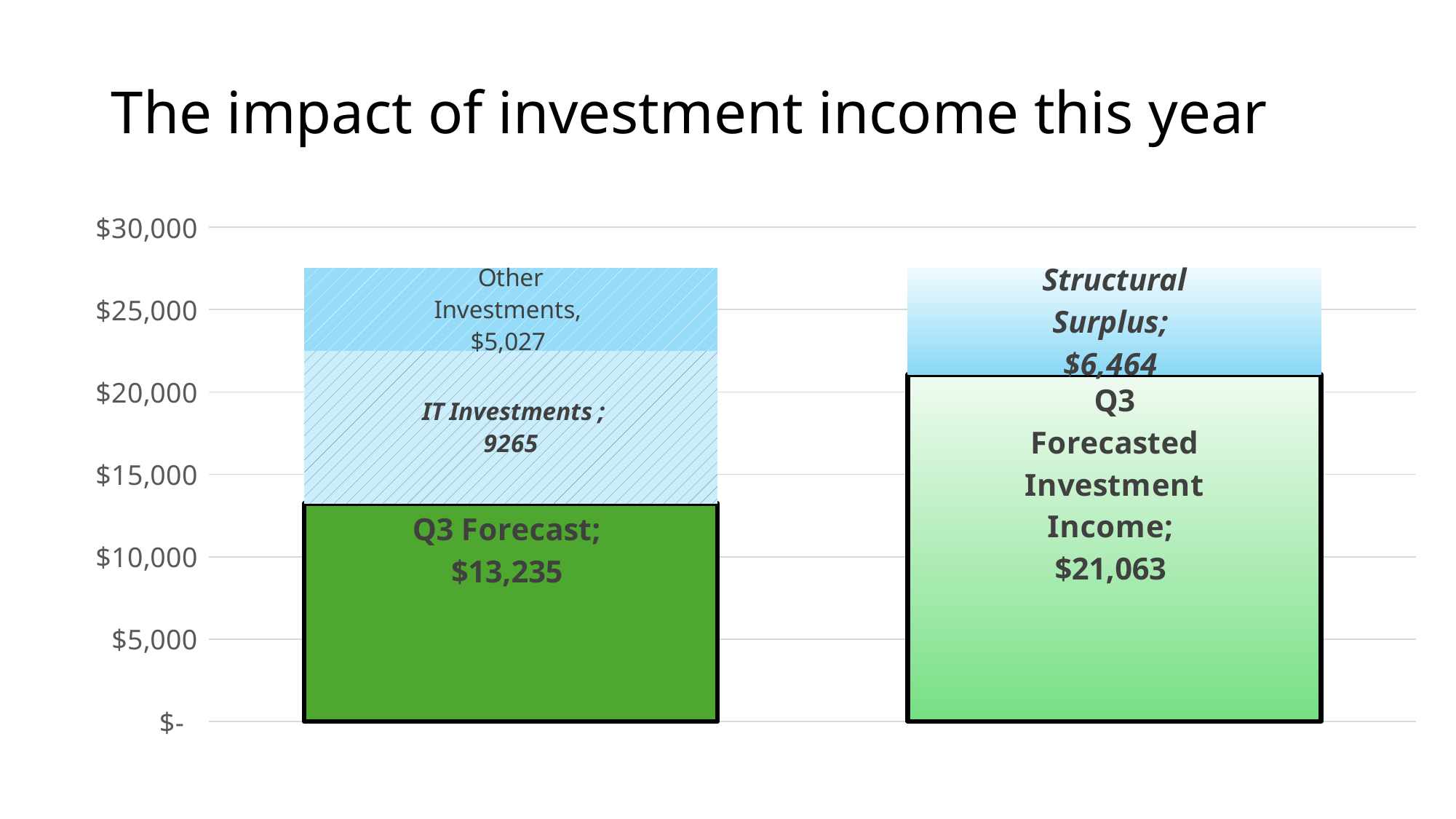
What is the difference between the Q3 Forecasted Investment Income ($21,063) and the Q3 Forecast ($13,235)? $7,828 What is the value of the Structural Surplus segment? $6,464 What is the value of the Q3 Forecasted Investment Income segment in the right bar? $21,063 Which segment in the left bar has the smallest value? Other Investments What is the value of the Q3 Forecast segment in the left bar? $13,235 What is the value of the Other Investments segment? $5,027 What kind of chart is shown on the slide? Stacked bar chart What is the value of the IT Investments segment? 9265 What is the total of the left stacked bar (Q3 Forecast, IT Investments and Other Investments)? $27,527 What is the total of the right stacked bar (Q3 Forecasted Investment Income and Structural Surplus)? $27,527 Which is larger, the Structural Surplus segment or the Other Investments segment? Structural Surplus What is the title of the slide? The impact of investment income this year